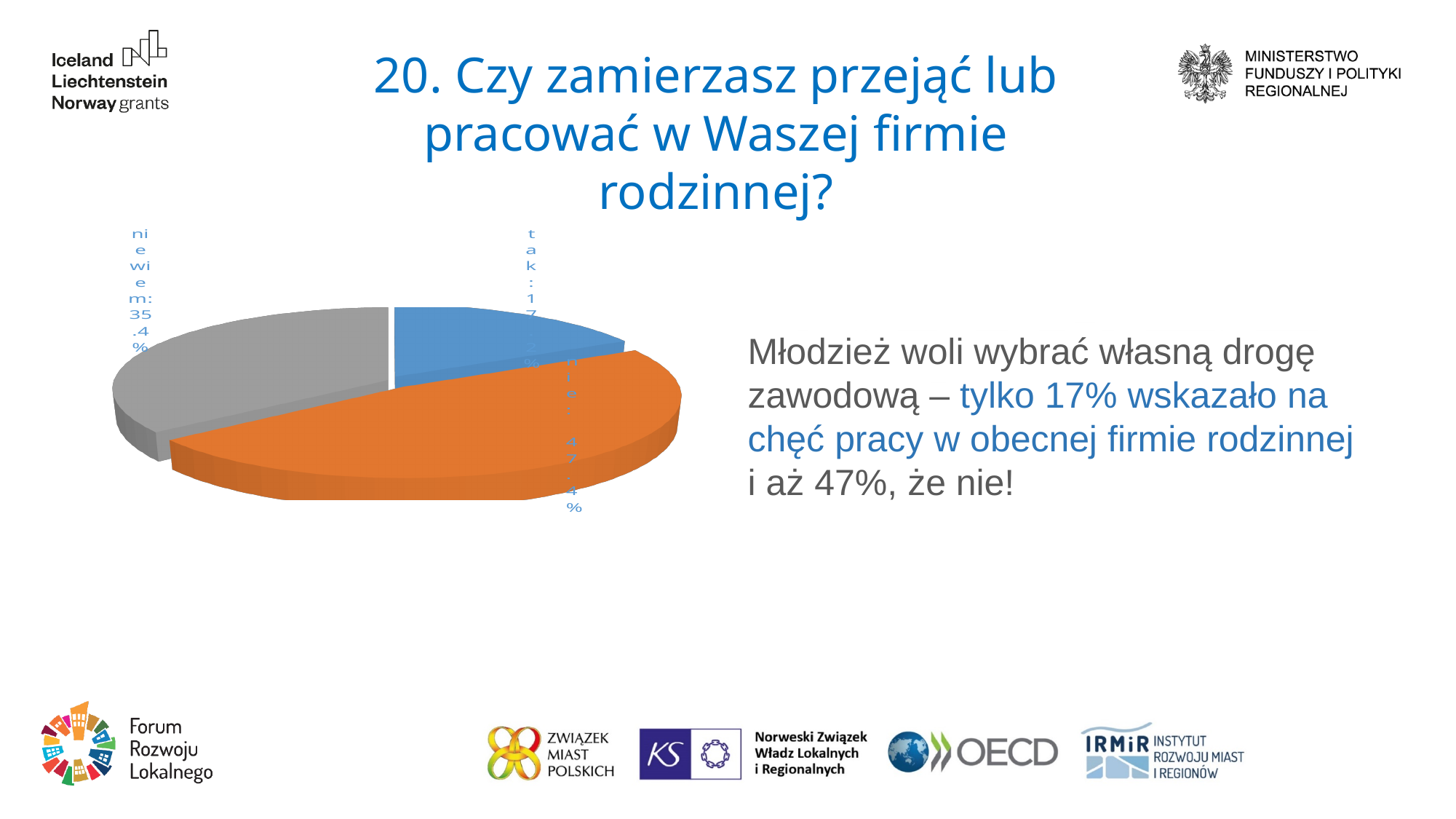
What colour is the "tak" slice of the pie chart? blue What kind of chart is shown on the slide? pie chart Which slice of the pie chart is the smallest? tak What percentage is shown for the "nie" slice? 47.4% What is the difference in percentage points between the "nie" slice and the "tak" slice? 30.2 Which slice of the pie chart is the largest? nie What percentage is shown for the "nie wiem" slice? 35.4% What colour is the "nie" slice of the pie chart? orange What is the difference in percentage points between the "nie wiem" slice and the "tak" slice? 18.2 How many slices does the pie chart have? 3 What percentage is shown for the "tak" slice? 17.2% Which is larger, the "nie" slice or the "nie wiem" slice? nie